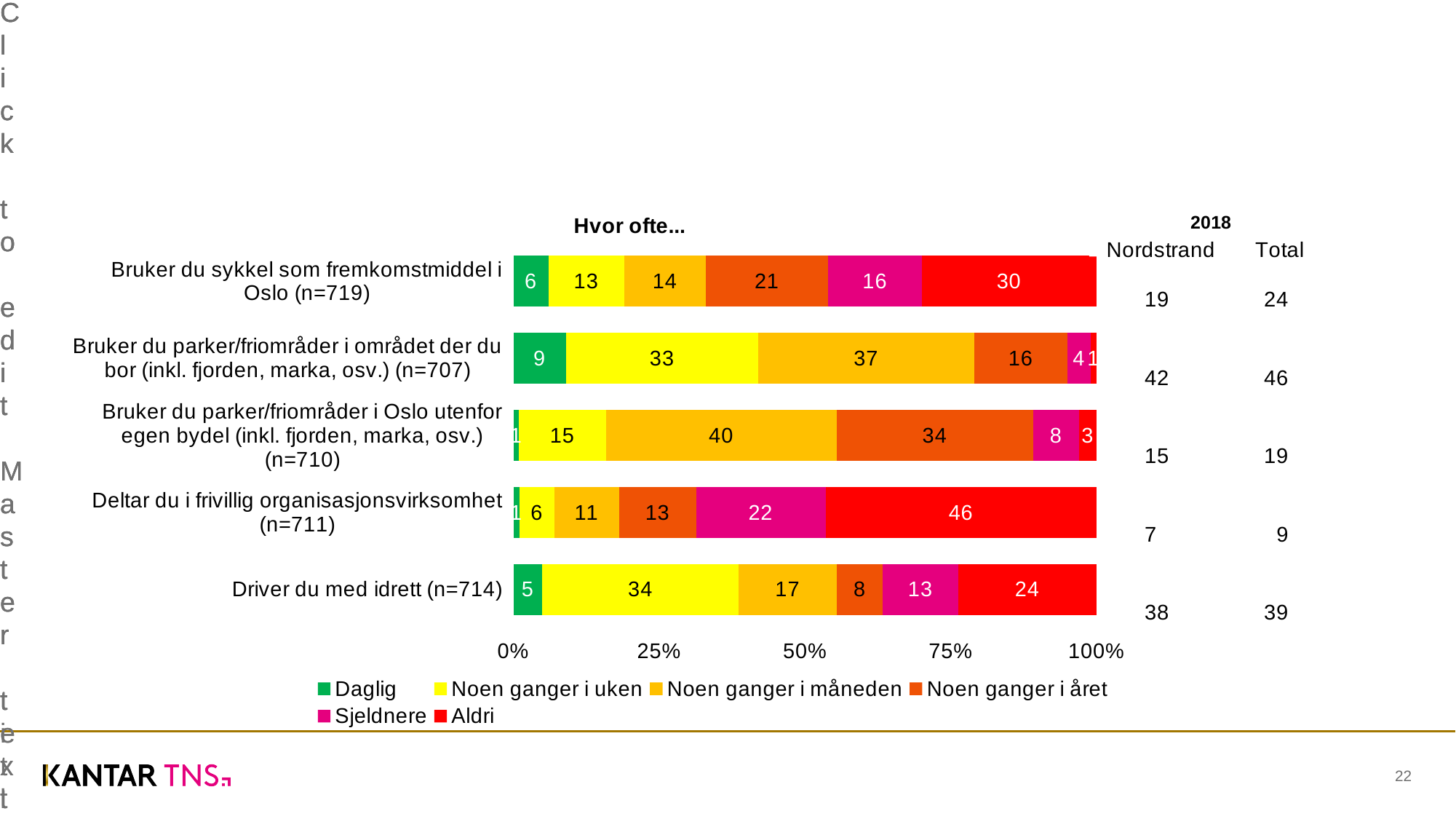
What kind of chart is shown on the slide? Stacked bar chart What is the value for "Noen ganger i måneden" in the bar "Bruker du parker/friområder i Oslo utenfor egen bydel (inkl. fjorden, marka, osv.) (n=710)"? 40 What is the title of the chart? Hvor ofte... What is the value for "Noen ganger i uken" in the bar "Driver du med idrett (n=714)"? 34 What is the difference between the "Aldri" values for "Bruker du sykkel som fremkomstmiddel i Oslo (n=719)" and "Driver du med idrett (n=714)"? 6 Which is larger: the "Sjeldnere" value for "Deltar du i frivillig organisasjonsvirksomhet (n=711)" or for "Bruker du sykkel som fremkomstmiddel i Oslo (n=719)"? Deltar du i frivillig organisasjonsvirksomhet (n=711) How many categories (questions) are shown in the chart? 5 What is the value for "Aldri" in the bar "Deltar du i frivillig organisasjonsvirksomhet (n=711)"? 46 How many series does the legend list? 6 What is the value for "Daglig" in the bar "Bruker du parker/friområder i området der du bor (inkl. fjorden, marka, osv.) (n=707)"? 9 Which category has the lowest value for "Noen ganger i uken"? Deltar du i frivillig organisasjonsvirksomhet (n=711) Which category has the highest value for "Aldri"? Deltar du i frivillig organisasjonsvirksomhet (n=711)